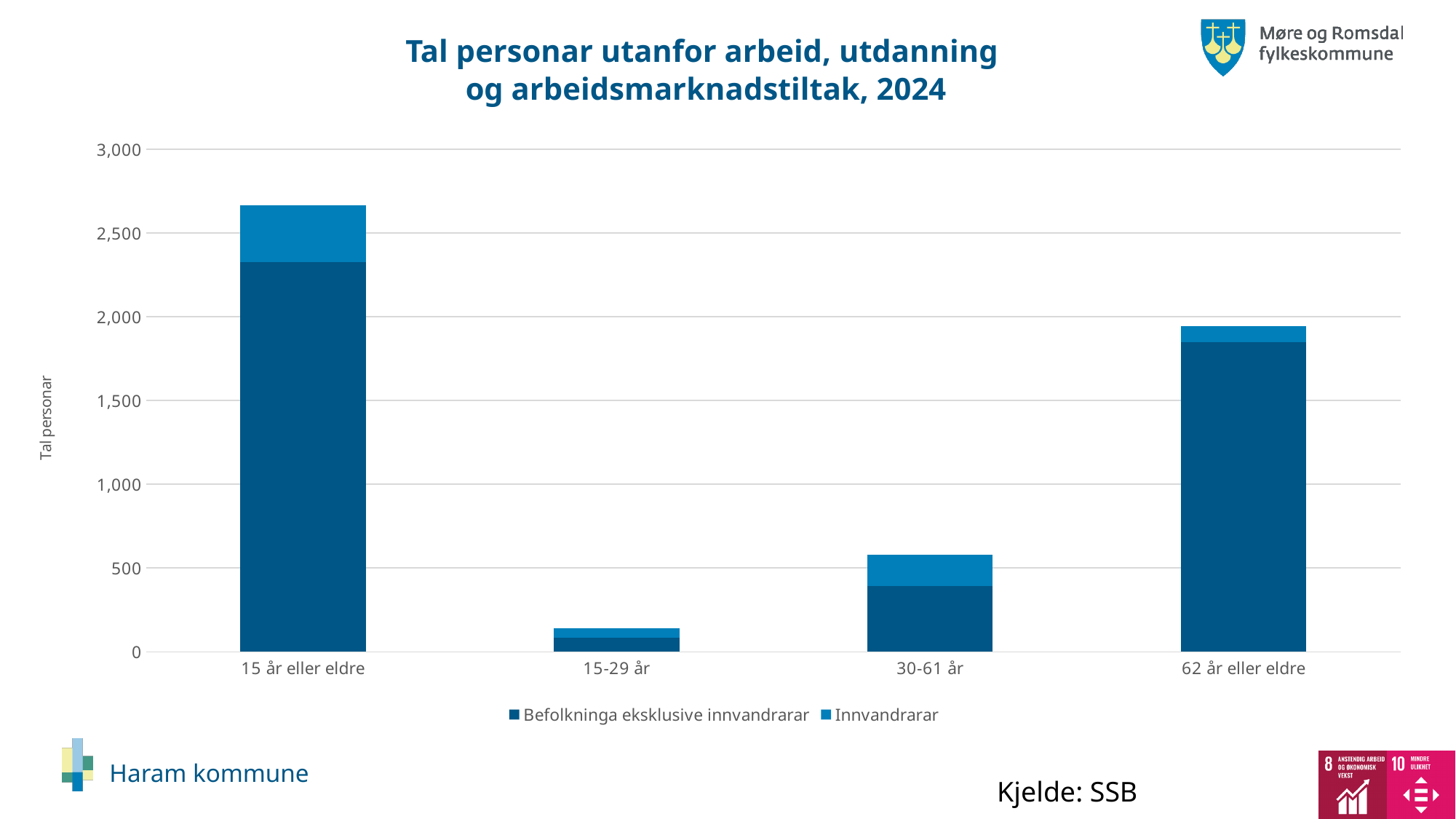
What is the label on the y axis? Tal personar How many series does the legend list? 2 Which series is shown in the lighter blue colour? Innvandrarar Which total bar is larger, 30-61 år or 15-29 år? 30-61 år Is the total bar for 62 år eller eldre greater or less than 2,000? less Is the total bar for 30-61 år greater or less than 500? greater Which category has the highest total bar? 15 år eller eldre Is the total bar for 15 år eller eldre greater or less than 2,500? greater How many age categories are shown on the x axis? 4 What kind of chart is shown on the slide? Stacked bar chart Which category has the lowest total bar? 15-29 år